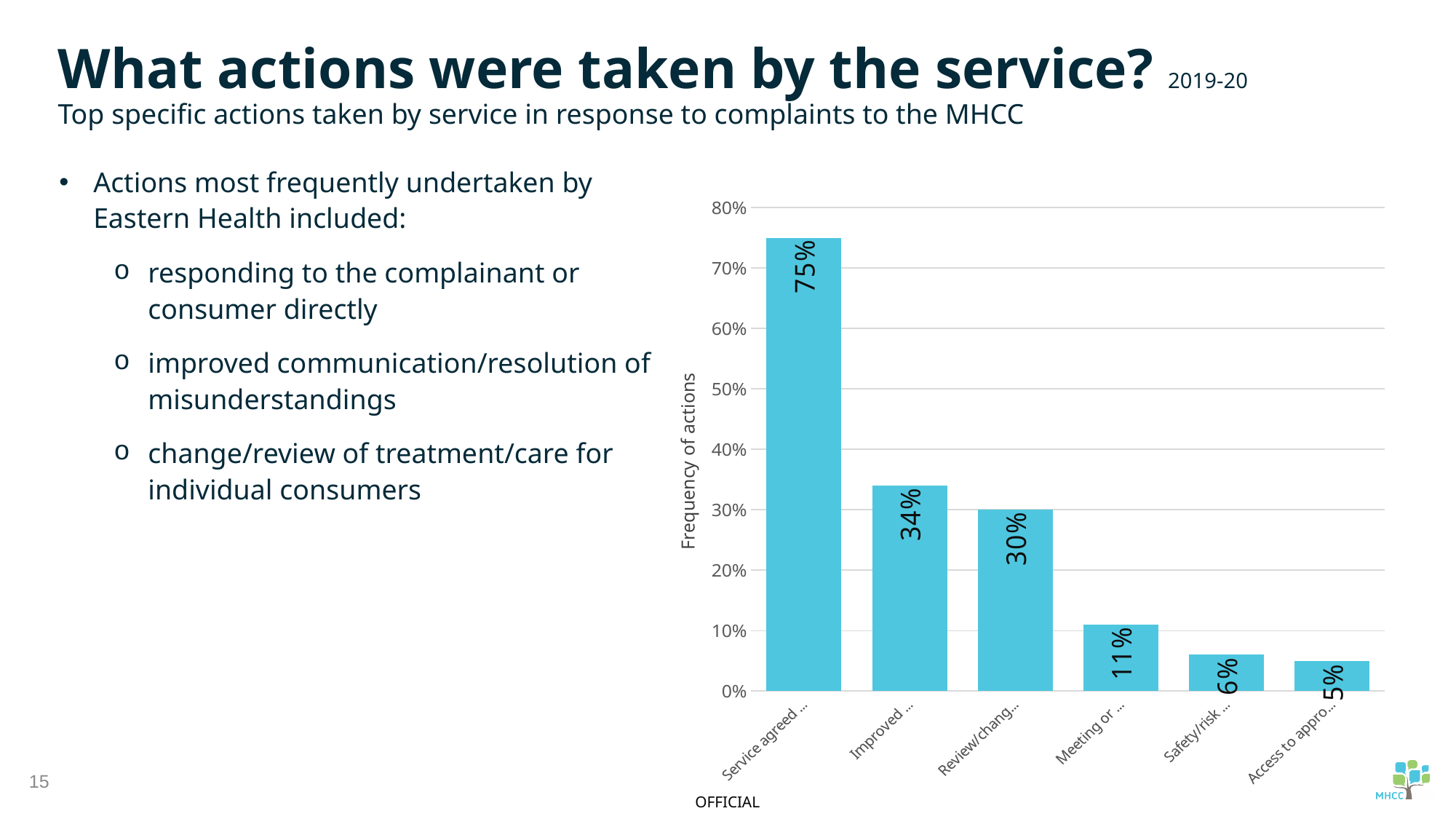
What is the label of the vertical axis of the chart? Frequency of actions What is the value of the first bar, labelled "Service agreed ..."? 75% Which category has the lowest value in the chart? Access to appro... (5%) What type of chart is shown on the slide? bar chart What is the value of the bar labelled "Safety/risk ..."? 6% What is the value of the bar labelled "Improved ..."? 34% What is the value of the bar labelled "Meeting or ..."? 11% Which category has the highest value in the chart? Service agreed ... (75%) Which is larger, the value for "Improved ..." or the value for "Review/chang..."? Improved ... What is the difference between the "Service agreed ..." bar and the "Improved ..." bar? 41% What is the value of the bar labelled "Review/chang..."? 30% How many bars (categories) are plotted in the chart? 6